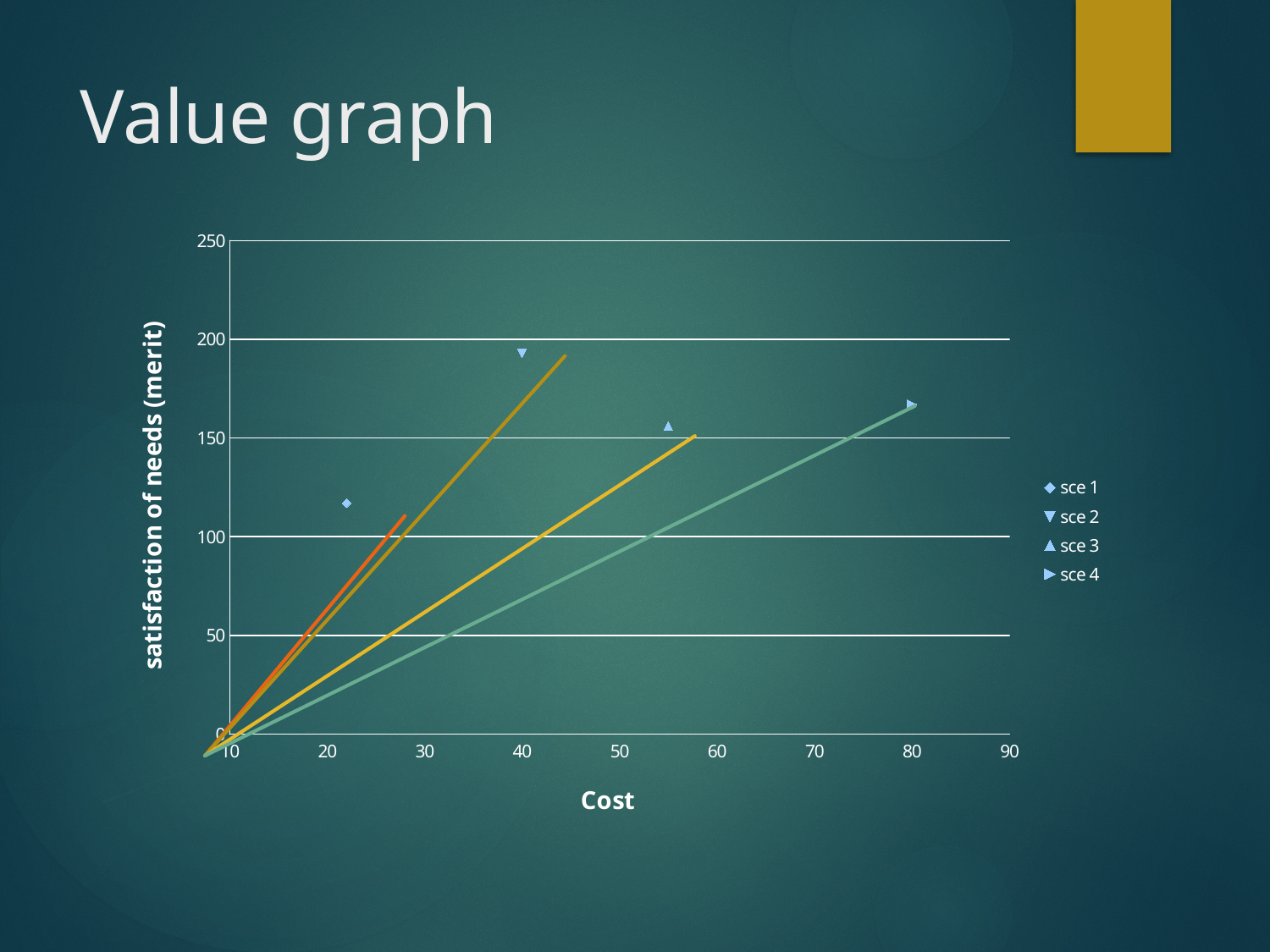
Which series has the lowest cost? sce 1 Is the satisfaction of needs value for sce 1 greater or less than 150? less What is the title of the slide's chart? Value graph Which series has the highest satisfaction of needs (merit) value? sce 2 What kind of chart is shown on the slide? scatter chart Which has the larger satisfaction of needs value, sce 2 or sce 4? sce 2 Which series has the lowest satisfaction of needs (merit) value? sce 1 What is the label of the vertical axis? satisfaction of needs (merit) Is the cost for sce 4 greater or less than 70? greater How many series does the legend list? 4 Is the satisfaction of needs value for sce 2 greater or less than 150? greater Which series has the highest cost? sce 4